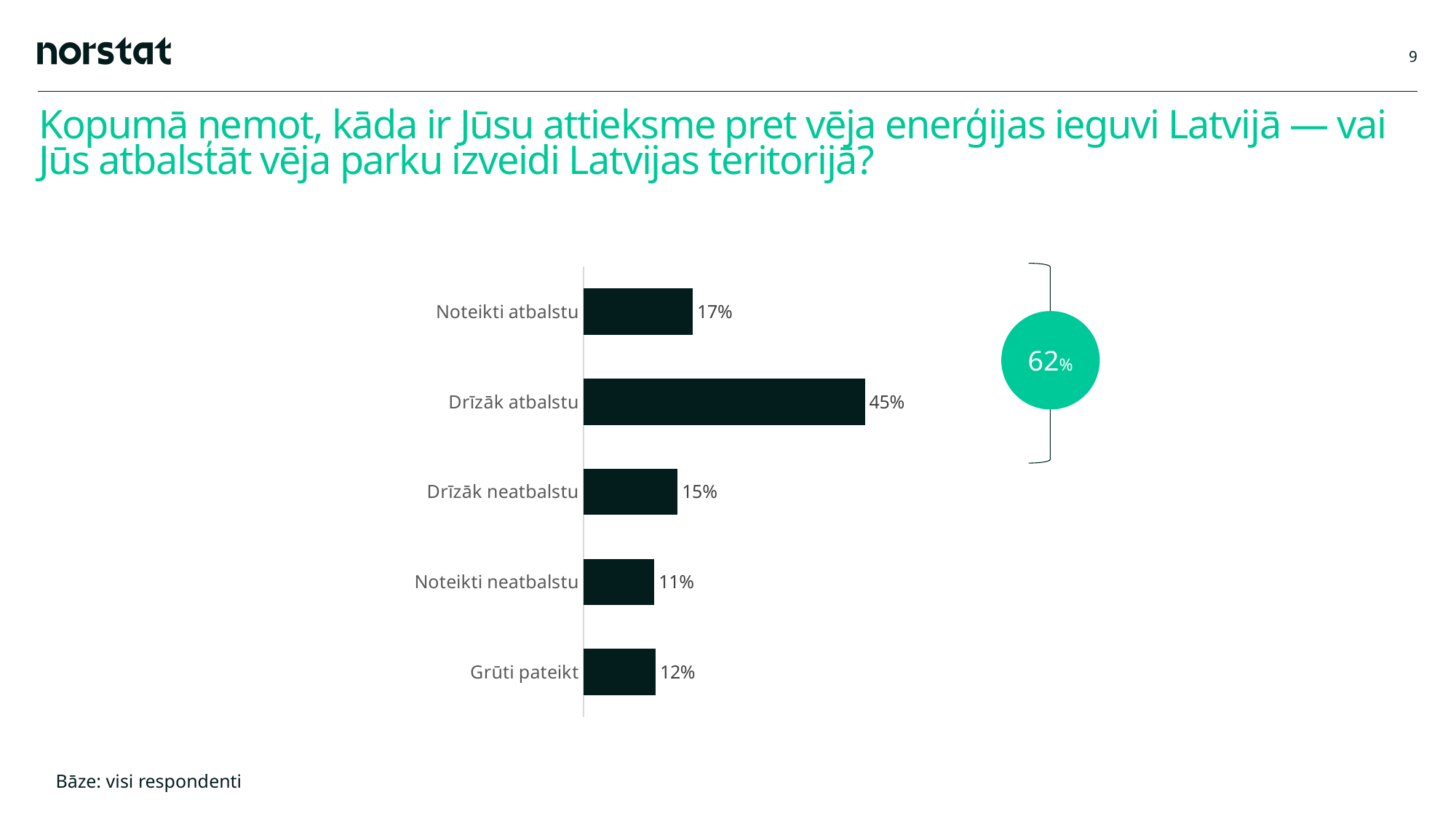
What combined percentage is shown in the green circle next to the two "atbalstu" bars? 62% Which category has the lowest value? Noteikti neatbalstu How many categories are shown in the chart? 5 What is the value for "Noteikti neatbalstu"? 11% Which category has the highest value? Drīzāk atbalstu What is the value for "Noteikti atbalstu"? 17% What is the value for "Drīzāk atbalstu"? 45% Which is larger, "Noteikti atbalstu" or "Drīzāk neatbalstu"? Noteikti atbalstu What is the difference between "Drīzāk atbalstu" and "Noteikti atbalstu"? 28% What is the difference between "Drīzāk neatbalstu" and "Noteikti neatbalstu"? 4% What kind of chart is shown on the slide? Bar chart What is the value for "Grūti pateikt"? 12%